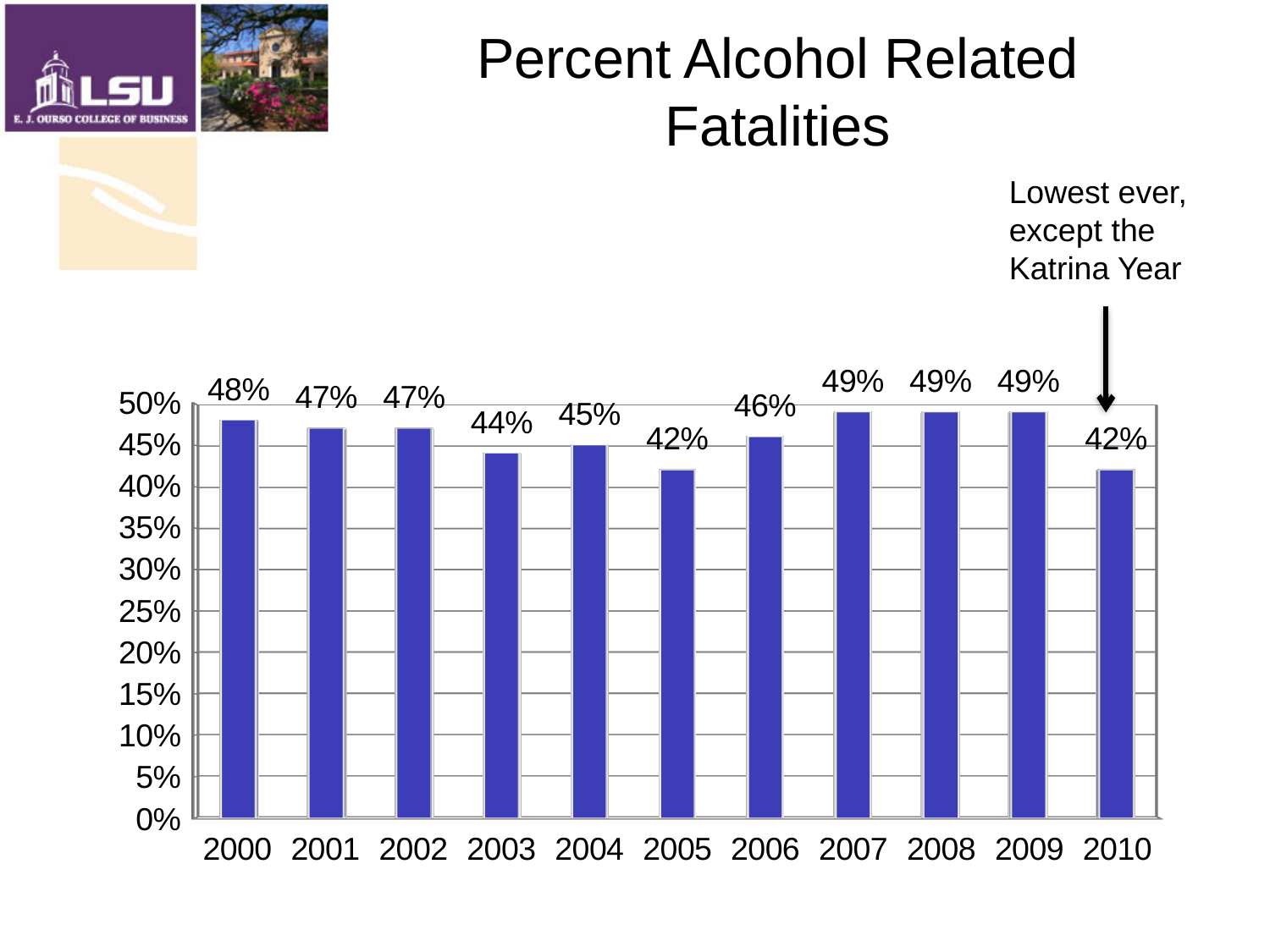
What is the title of the chart? Percent Alcohol Related Fatalities What is the percent of alcohol related fatalities in 2003? 44% What is the percent of alcohol related fatalities in 2005? 42% Do the values rise or fall from 2005 to 2009? Rise What is the difference between the 2000 value and the 2003 value? 4% What is the percent of alcohol related fatalities in 2000? 48% How many years are shown on the x axis? 11 What is the percent of alcohol related fatalities in 2010? 42% What does the annotation with the arrow pointing to the 2010 bar say? Lowest ever, except the Katrina Year Which is larger, the value for 2004 or the value for 2006? 2006 What kind of chart is shown on the slide? Bar chart What is the difference between the 2009 value and the 2010 value? 7%